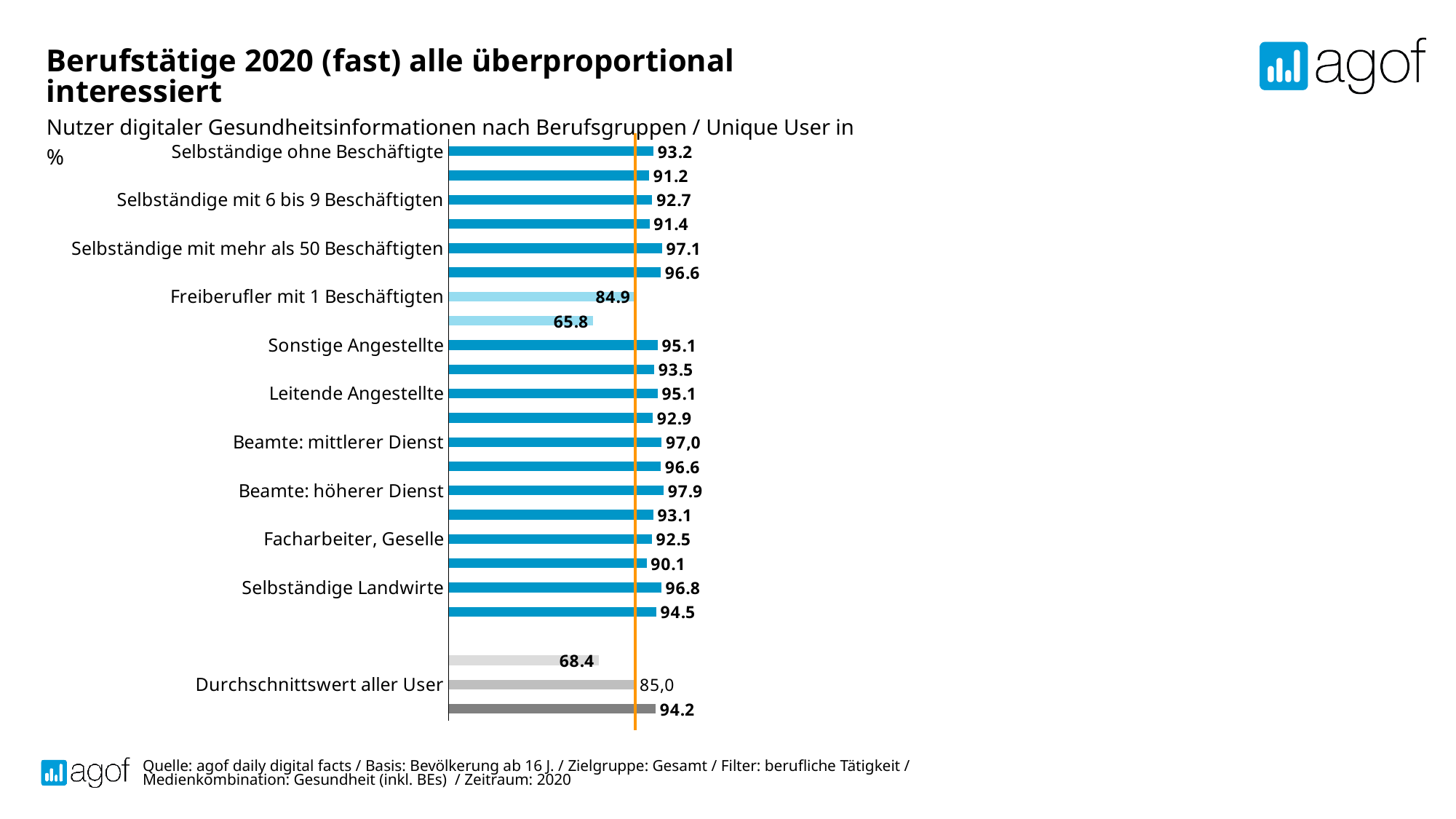
What is the value for Selbständige Landwirte? 96.8 What is the difference between the values for Selbständige mit mehr als 50 Beschäftigten and Selbständige ohne Beschäftigte? 3.9 Which is larger, the value for Beamte: mittlerer Dienst or for Leitende Angestellte? Beamte: mittlerer Dienst What kind of chart is shown on the slide? bar chart What is the value for Beamte: höherer Dienst? 97.9 What is the difference between the values for Beamte: höherer Dienst and Freiberufler mit 1 Beschäftigten? 13.0 Which is larger, the value for Sonstige Angestellte or for Facharbeiter, Geselle? Sonstige Angestellte What colour is the bar for Freiberufler mit 1 Beschäftigten? light blue What is the value shown for Durchschnittswert aller User? 85,0 Which labelled occupational group has the highest value? Beamte: höherer Dienst What is the value for Selbständige ohne Beschäftigte? 93.2 What is the value for Freiberufler mit 1 Beschäftigten? 84.9